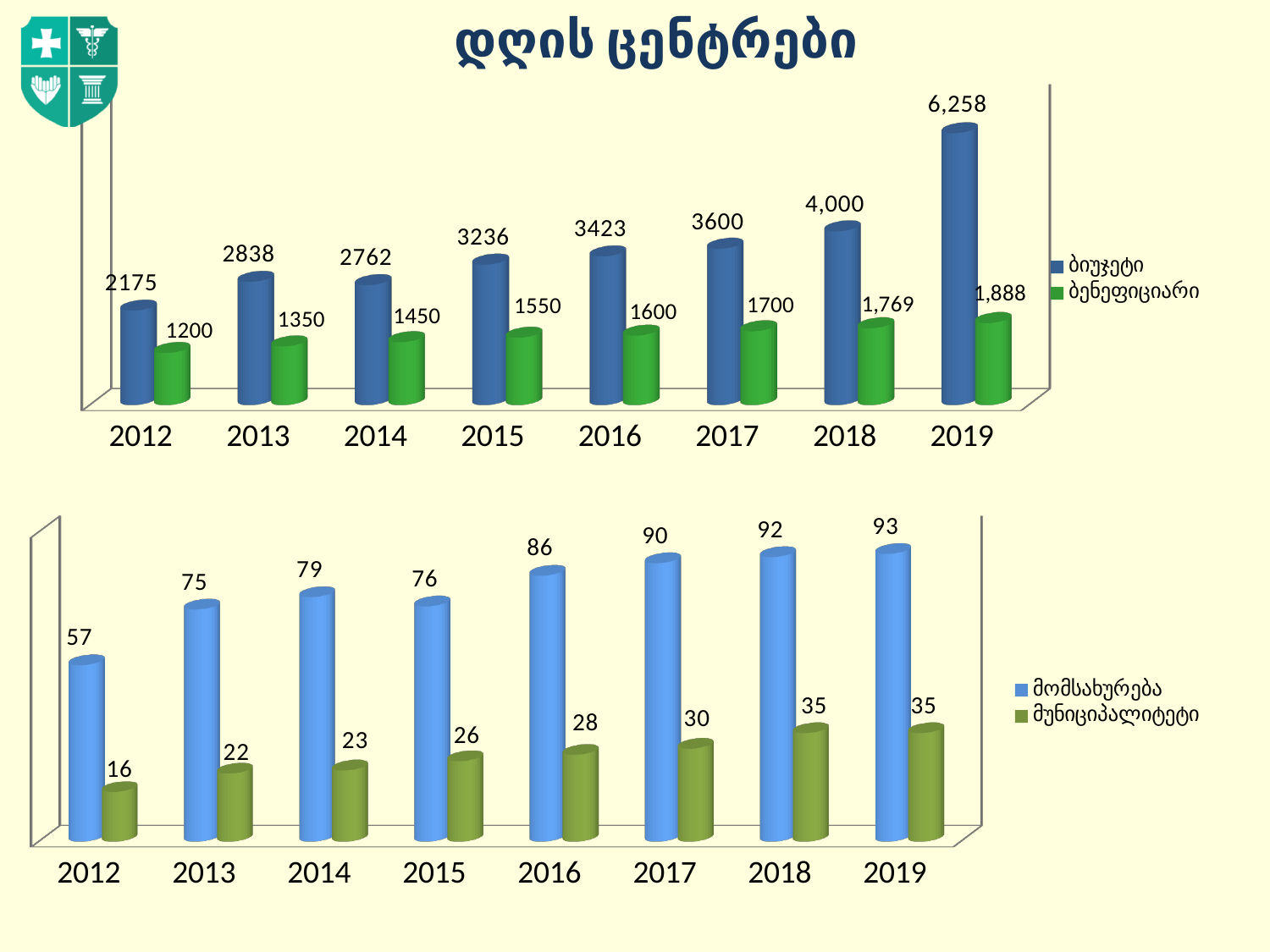
What type of chart is the bottom chart? Bar chart In the top chart, how many series does the legend list? 2 In the bottom chart, which year has the highest მომსახურება value? 2019 How many years are shown on the x axis of the bottom chart? 8 In the bottom chart, what is the value for მომსახურება in 2016? 86 In the top chart, which year has the lowest ბიუჯეტი value? 2012 In the bottom chart, what is the difference between the მომსახურება and მუნიციპალიტეტი values in 2012? 41 In the bottom chart, what is the value for მუნიციპალიტეტი in 2013? 22 In the top chart, what is the value for ბიუჯეტი in 2019? 6,258 In the top chart, what is the value for ბენეფიციარი in 2015? 1550 In the top chart, what is the difference between the ბიუჯეტი values for 2018 and 2017? 400 In the top chart, which is larger: the ბიუჯეტი value for 2013 or for 2014? 2013